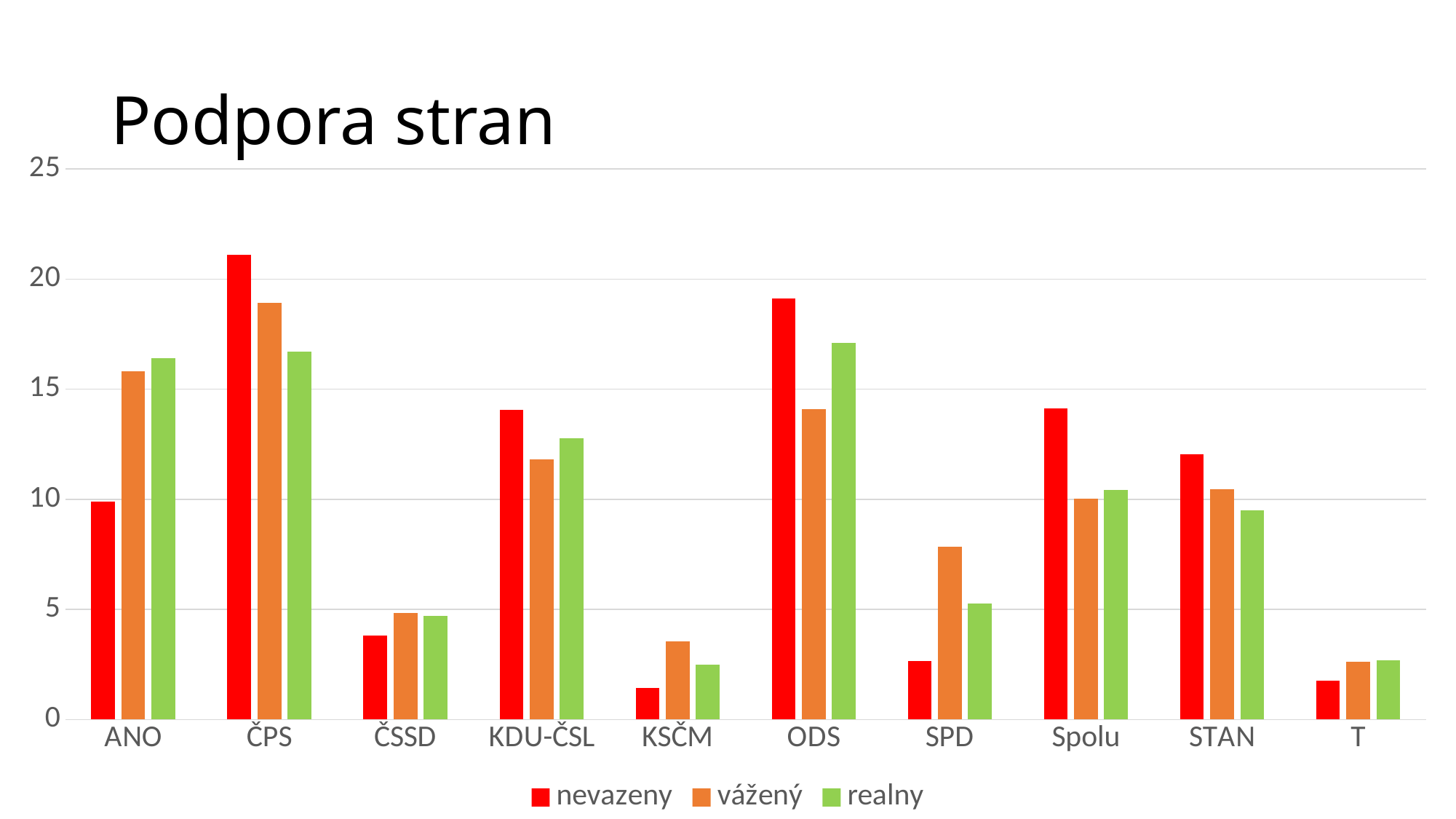
What is the title of the chart? Podpora stran Is the vážený value for SPD greater or less than 5? greater How many parties (categories) are shown on the x axis? 10 Which party has the highest nevazeny value? ČPS What kind of chart is shown on the slide? bar chart Which colour represents the realny series in the legend? green Which party has the lowest nevazeny value? KSČM Which party has the highest vážený value? ČPS Which is larger for ODS: the nevazeny value or the vážený value? nevazeny Is the nevazeny value for KSČM greater or less than 5? less Is the nevazeny value for ČPS greater or less than 20? greater How many series does the legend list? 3